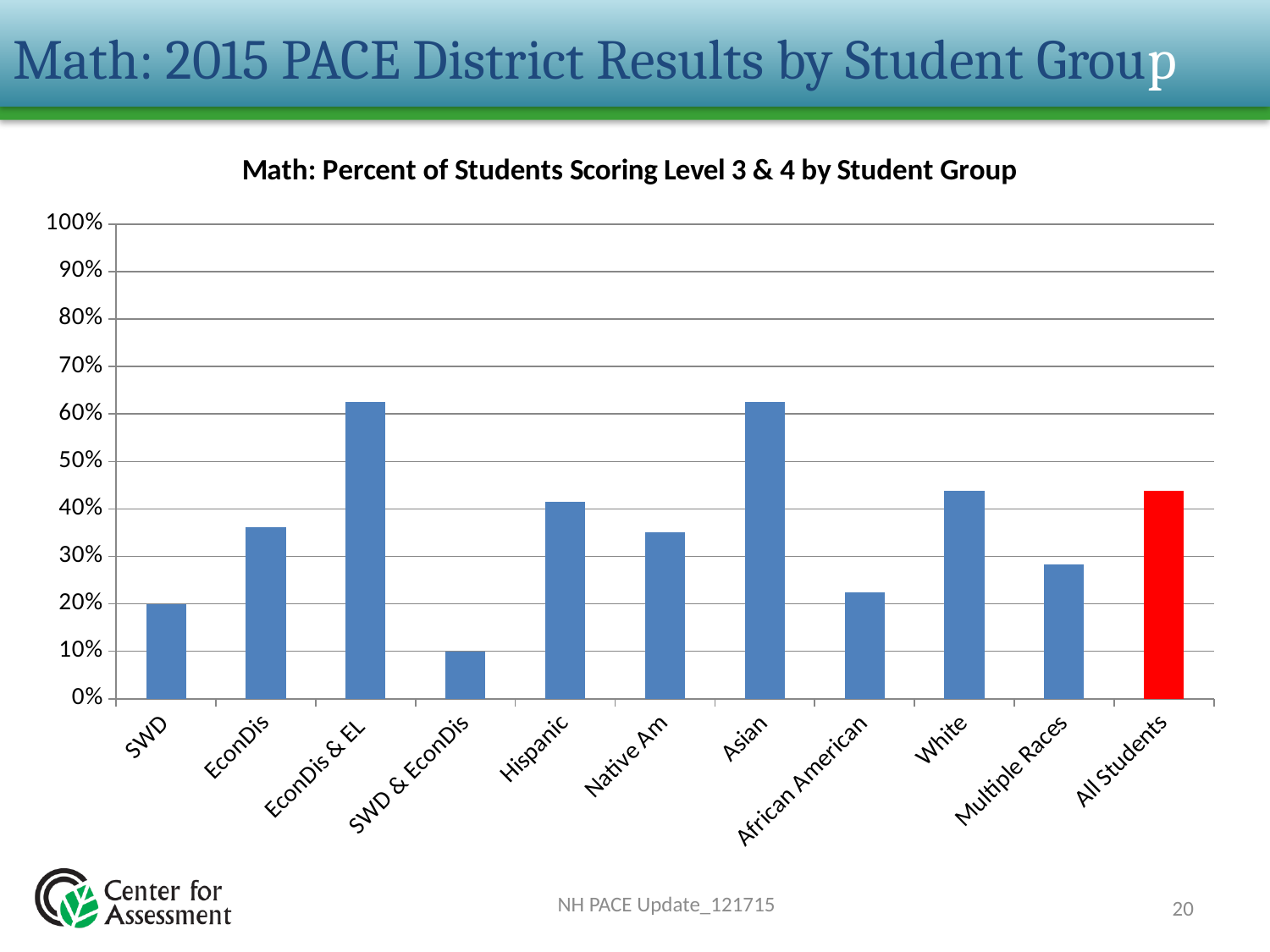
Which bar on the chart is coloured red? All Students Is the value for Asian greater or less than 60%? greater How many student groups are plotted on the chart? 11 Which student group has the lowest percent of students scoring Level 3 & 4? SWD & EconDis Is the value for EconDis greater or less than 30%? greater Which is larger, the value for Hispanic or the value for African American? Hispanic What kind of chart is shown on the slide? bar chart Is the value for Native Am greater or less than 40%? less Which is larger, the value for White or the value for Multiple Races? White